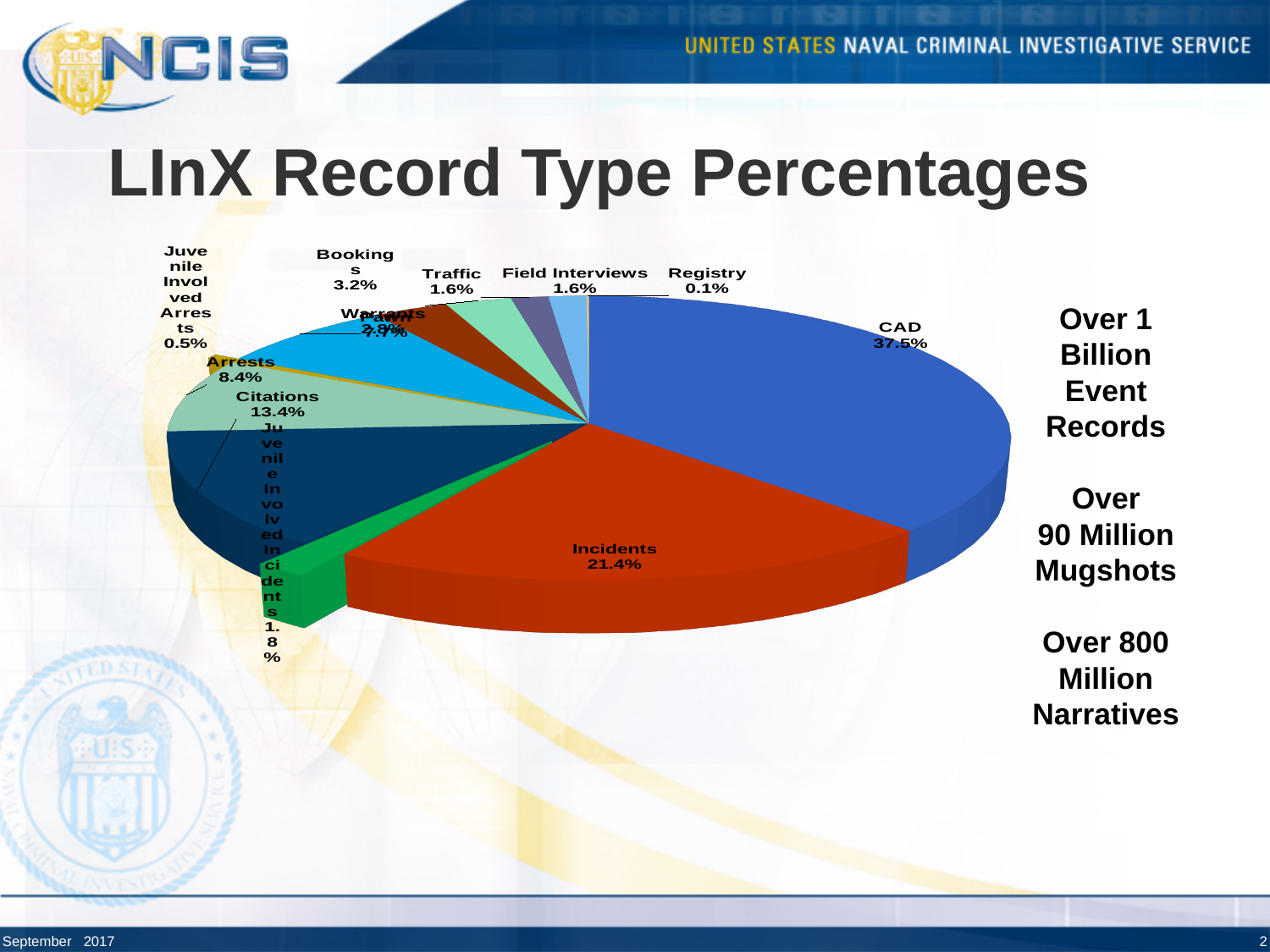
What percentage is shown for Citations? 13.4% Which record type has the largest share of the pie? CAD What percentage of the pie does CAD account for? 37.5% What percentage is shown for Registry? 0.1% Which record type has the smallest share of the pie? Registry What percentage is shown for Bookings? 3.2% What percentage is shown for Incidents? 21.4% What percentage is shown for Arrests? 8.4% What type of chart is shown on the slide? Pie chart Which has a larger share, Citations or Arrests? Citations What is the title of the chart on the slide? LInX Record Type Percentages What is the difference in percentage points between CAD and Incidents? 16.1%